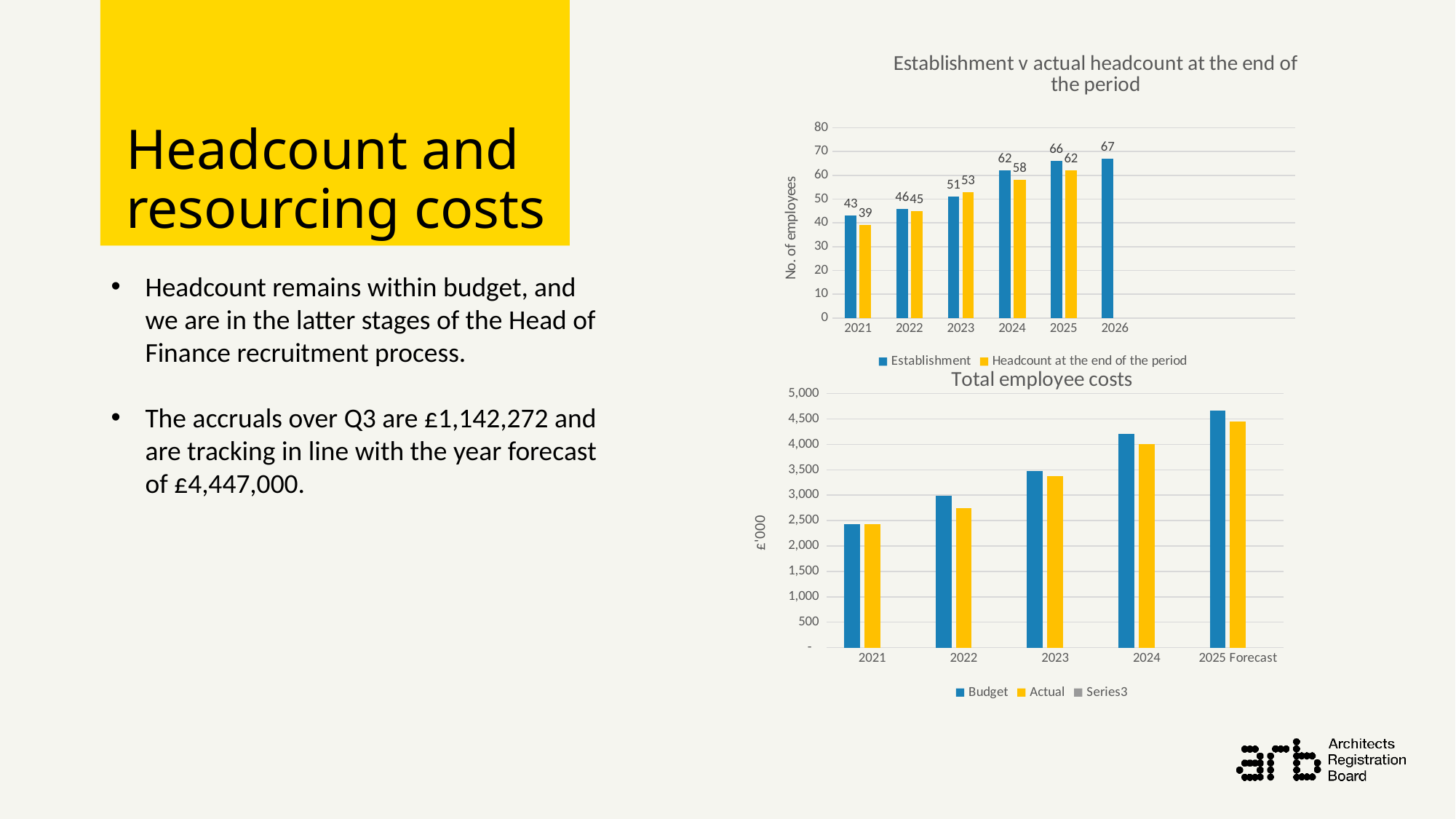
In the 'Establishment v actual headcount at the end of the period' chart, does the Establishment value rise or fall from 2021 to 2026? rise In the 'Establishment v actual headcount at the end of the period' chart, which year has the lowest Headcount at the end of the period? 2021 In the 'Establishment v actual headcount at the end of the period' chart, which year has the highest Establishment value? 2026 In the 'Total employee costs' chart, how many series does the legend list? 3 In the 'Establishment v actual headcount at the end of the period' chart, what is the difference between Establishment and Headcount at the end of the period in 2025? 4 In the 'Establishment v actual headcount at the end of the period' chart, what is the Establishment value for 2024? 62 In the 'Establishment v actual headcount at the end of the period' chart, what is the Headcount at the end of the period for 2021? 39 In the 'Total employee costs' chart, is the Actual value for 2022 greater or less than 3,000? less In the 'Total employee costs' chart, is the Budget value for 2024 greater or less than 4,000? greater In the 'Establishment v actual headcount at the end of the period' chart, how many years are shown on the x axis? 6 In the 'Establishment v actual headcount at the end of the period' chart, which is larger in 2023: Establishment or Headcount at the end of the period? Headcount at the end of the period What kind of chart is the 'Total employee costs' chart? bar chart